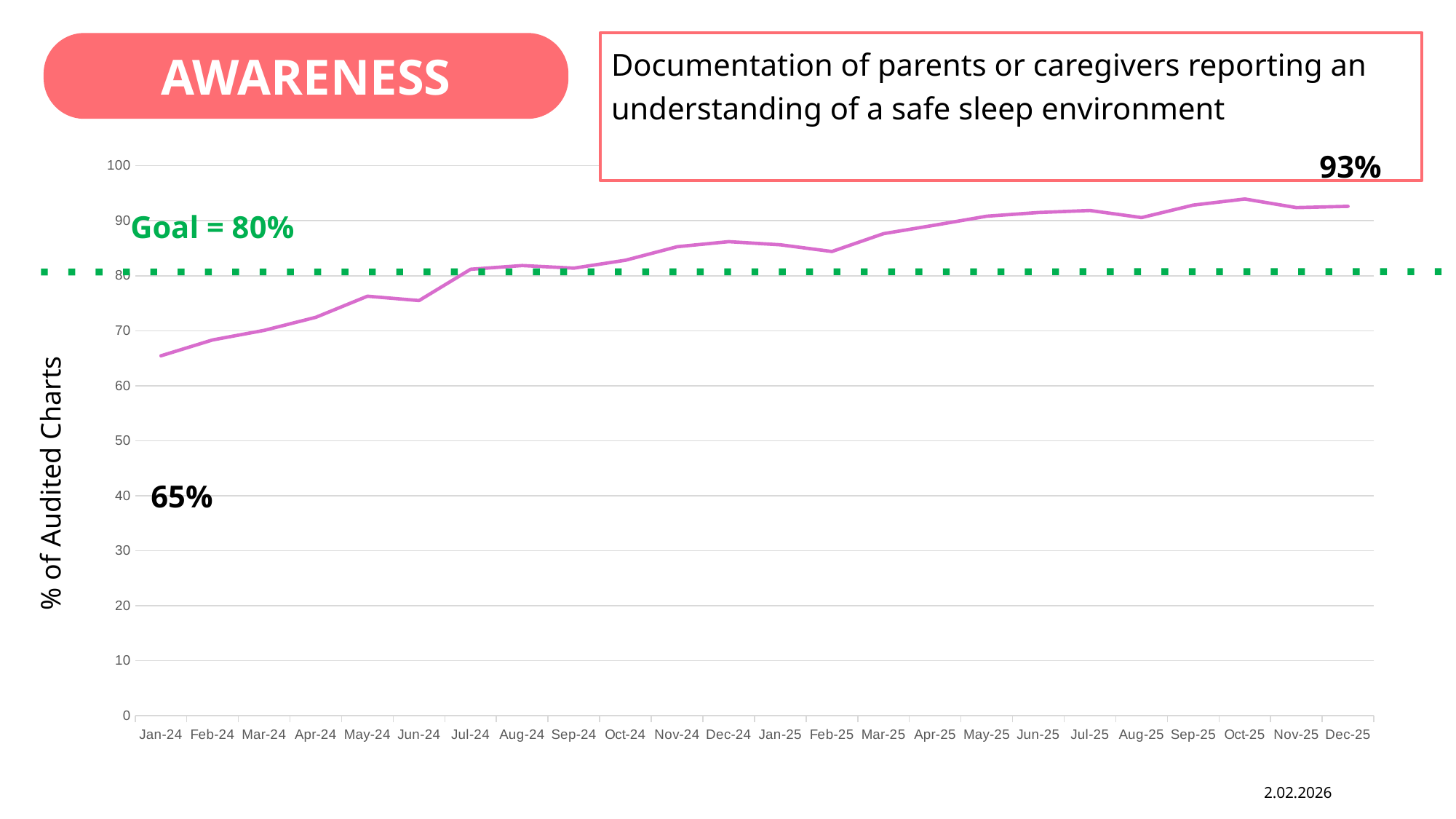
What is the difference between the Dec-25 value and the Jan-24 value? 28% Do the values generally rise or fall from Jan-24 to Dec-25? rise Is the value for Oct-25 greater or less than 90? greater Which is larger, the value for Dec-25 or the value for Jan-24? Dec-25 Is the value for Jun-24 greater or less than 80? less What is the value for Jan-24? 65% How many months are plotted on the x axis? 24 Is the value for Dec-24 greater or less than 80? greater Which month has the lowest value? Jan-24 What is the goal value marked by the dotted line? 80% What type of chart is shown on the slide? line chart What is the value for Dec-25? 93%